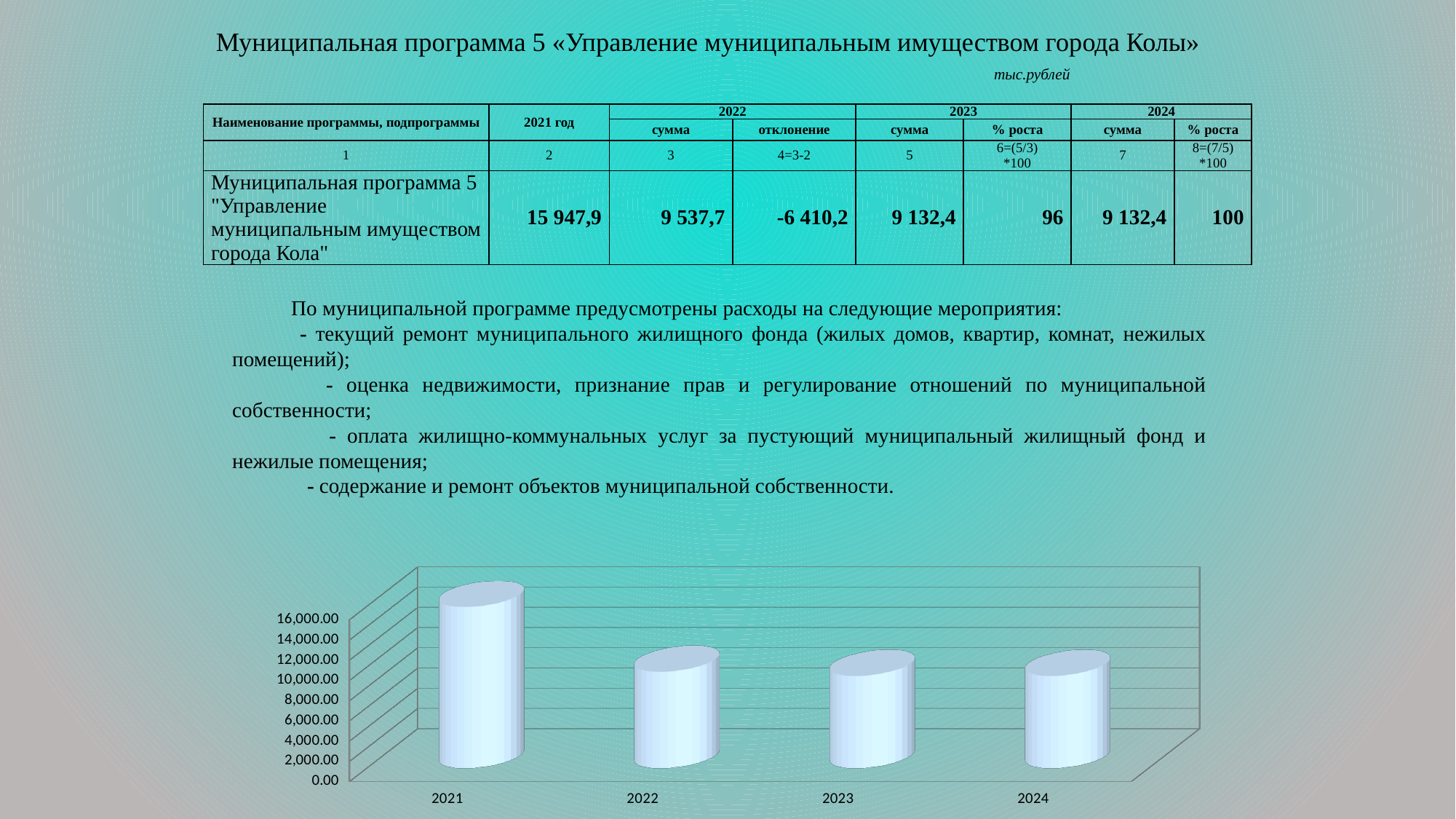
Is the value for 2024 in the chart greater or less than 6,000.00? greater Is the value for 2021 in the chart greater or less than 14,000.00? greater What is the first category label on the chart's horizontal axis? 2021 What kind of chart is shown at the bottom of the slide? bar chart Is the value for 2023 in the chart greater or less than 12,000.00? less Which is larger in the chart, the value for 2024 or the value for 2021? 2021 Which is larger in the chart, the value for 2021 or the value for 2022? 2021 How many bars (years) does the chart show? 4 Do the values in the chart rise or fall from 2021 to 2022? fall What is the highest tick label shown on the chart's vertical axis? 16,000.00 Which year has the highest bar in the chart? 2021